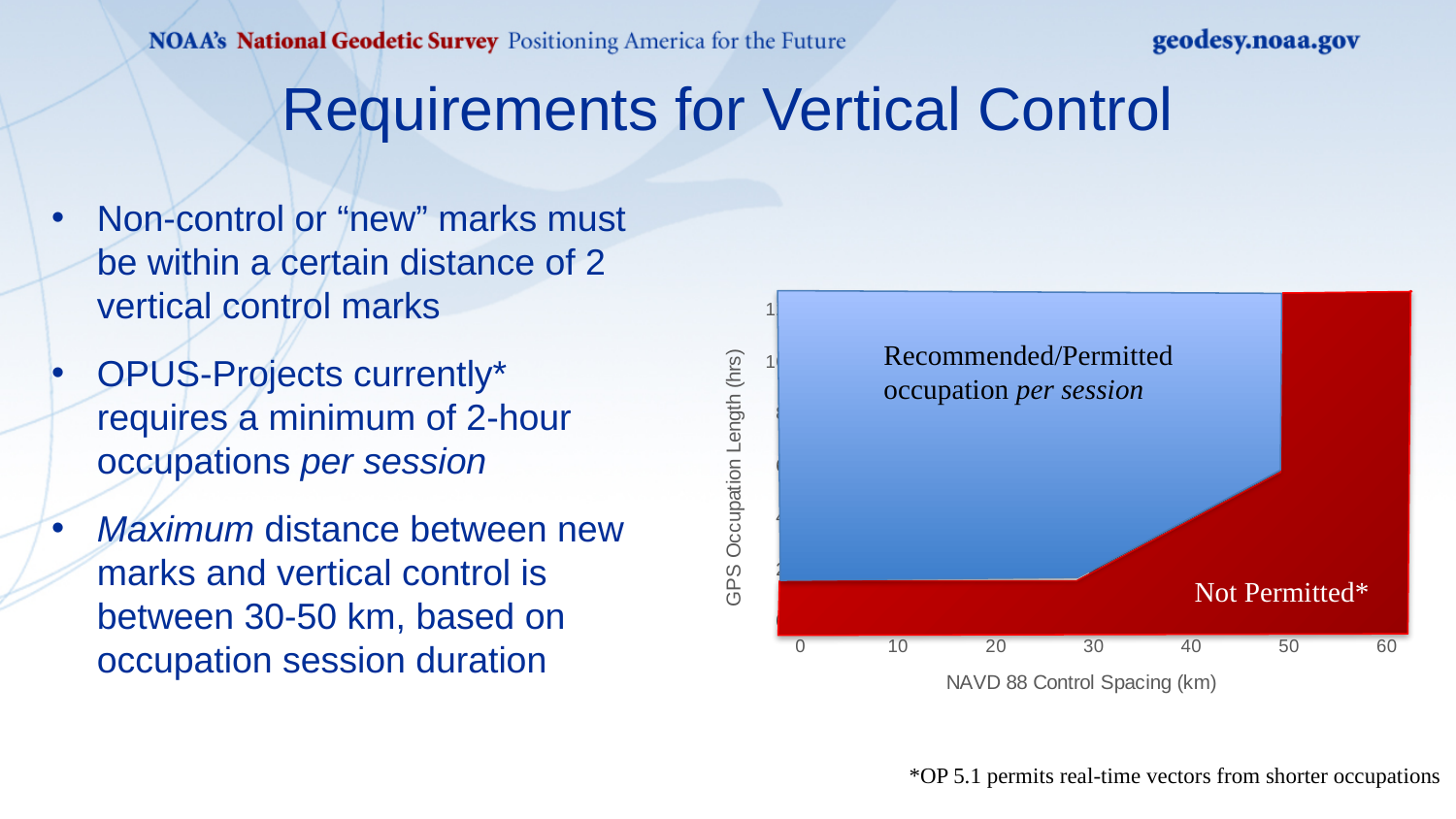
What kind of chart is shown on the slide? Area chart What does the blue region of the chart represent? Recommended/Permitted occupation per session Does the lower boundary of the permitted region rise or fall as NAVD 88 control spacing increases from 30 km to 50 km? Rise At what NAVD 88 control spacing (km) does the blue permitted region end on the x axis? 50 How many tick labels are shown along the x axis of the chart? 7 What is the highest value shown on the x axis of the chart? 60 What is the label of the y axis of the chart? GPS Occupation Length (hrs) Is the NAVD 88 control spacing at which the permitted region ends greater or less than 40 km? greater What does the red region of the chart represent? Not Permitted* What is the label of the x axis of the chart? NAVD 88 Control Spacing (km)